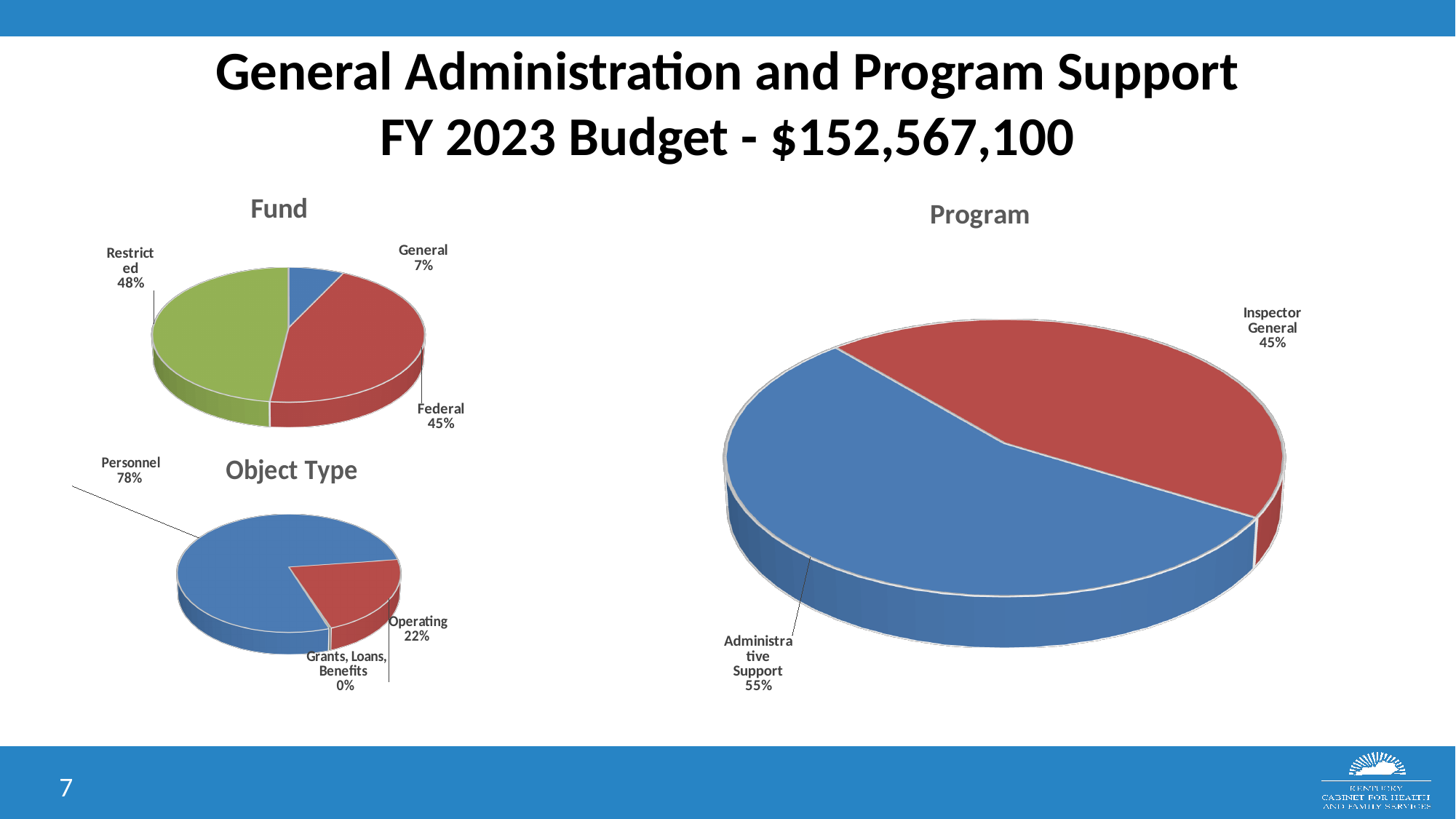
In the Fund chart, which fund source has the smallest share? General In the Fund chart, what share of the budget is Restricted? 48% In the Fund chart, what colour is the Restricted slice? Green In the Fund chart, how many slices are there? 3 In the Object Type chart, which object type has the smallest share? Grants, Loans, Benefits In the Object Type chart, what share is Personnel? 78% In the Object Type chart, what is the difference between the Personnel and Operating shares? 56% What kind of chart is the Program chart? Pie chart In the Fund chart, which fund source has the largest share? Restricted In the Program chart, what share is Administrative Support? 55% In the Program chart, which is larger, Inspector General or Administrative Support? Administrative Support